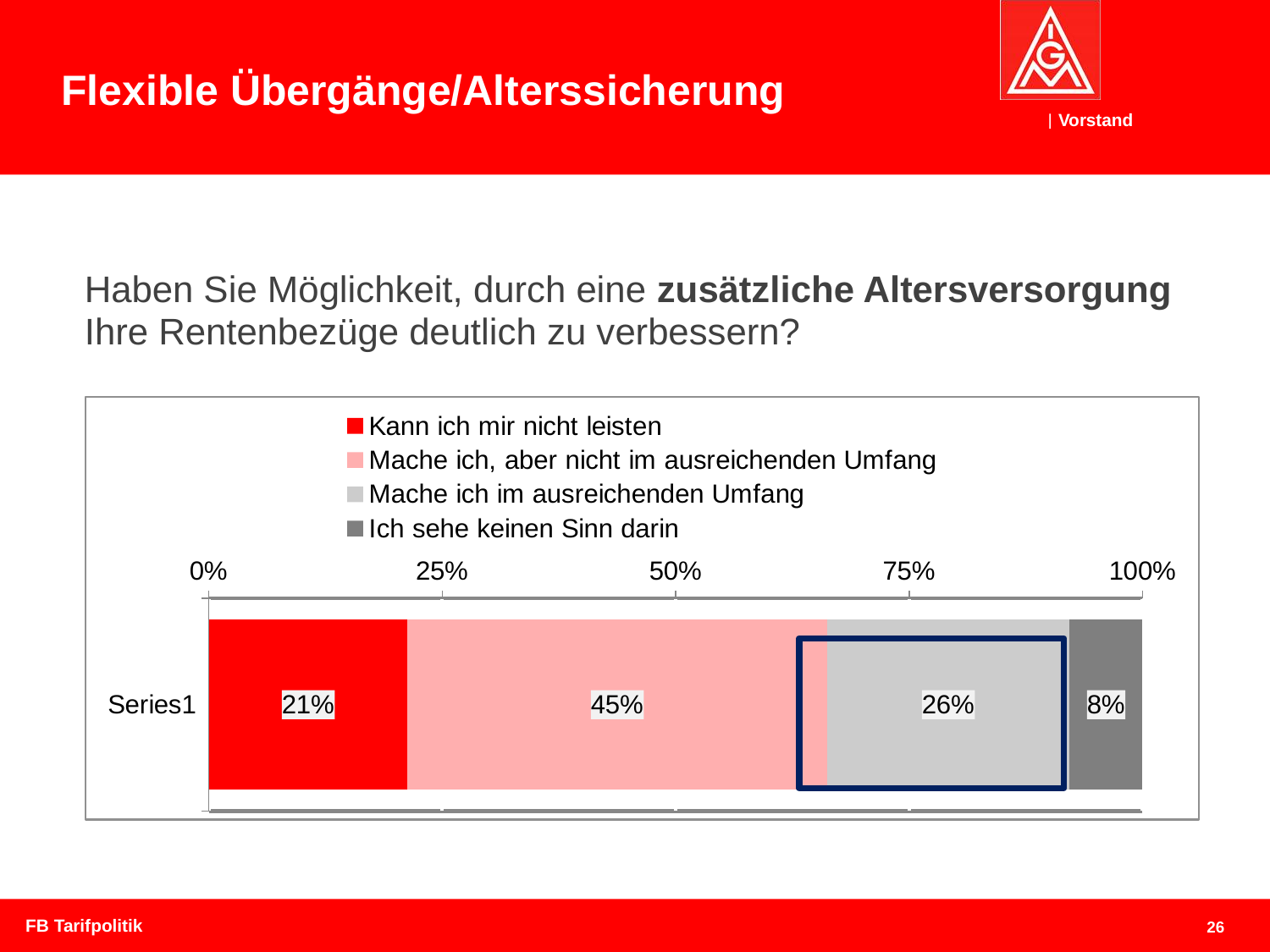
How many series does the legend list? 4 Which response has the smallest share? Ich sehe keinen Sinn darin What is the difference between the shares for "Mache ich, aber nicht im ausreichenden Umfang" and "Mache ich im ausreichenden Umfang"? 19% What percentage is shown for "Ich sehe keinen Sinn darin"? 8% What percentage is shown for "Kann ich mir nicht leisten"? 21% What percentage is shown for "Mache ich, aber nicht im ausreichenden Umfang"? 45% What is the total of all segments in the stacked bar? 100% Which response has the largest share? Mache ich, aber nicht im ausreichenden Umfang What percentage is shown for "Mache ich im ausreichenden Umfang"? 26% Which is larger: the share for "Kann ich mir nicht leisten" or for "Mache ich im ausreichenden Umfang"? Mache ich im ausreichenden Umfang Which legend entry is shown in bright red? Kann ich mir nicht leisten What kind of chart is shown on the slide? Stacked bar chart